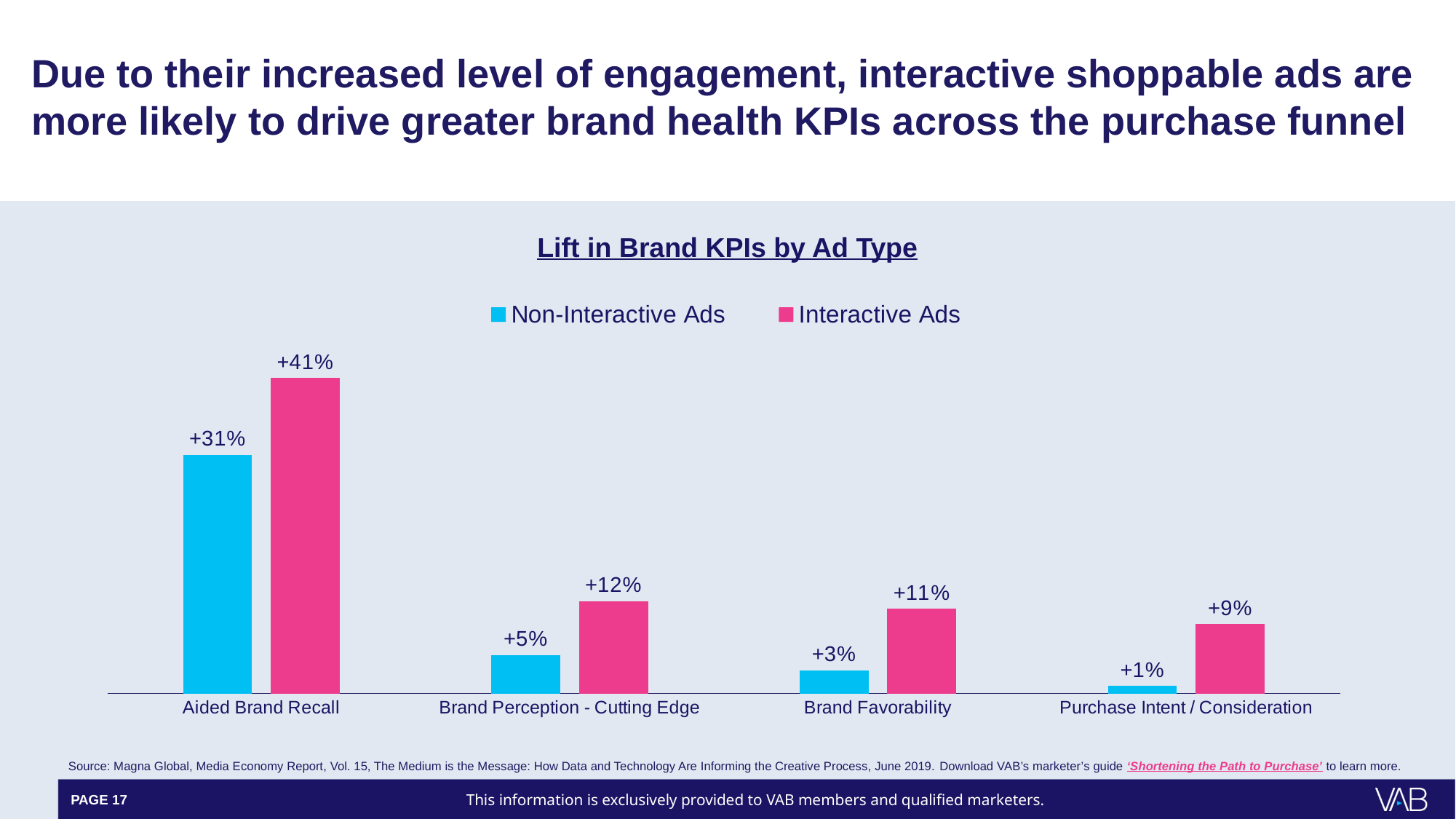
What is the difference between the Interactive Ads and Non-Interactive Ads lift for Brand Favorability? 8 percentage points How many series does the legend list? 2 For Brand Perception - Cutting Edge, which ad type has the larger lift? Interactive Ads What type of chart is shown on the slide? Bar chart How many KPI categories are shown on the x axis? 4 Which KPI shows the highest lift for Interactive Ads? Aided Brand Recall What is the lift in Purchase Intent / Consideration for Interactive Ads? +9% What is the lift in Brand Favorability for Non-Interactive Ads? +3% What is the lift in Aided Brand Recall for Interactive Ads? +41% Which KPI shows the lowest lift for Non-Interactive Ads? Purchase Intent / Consideration What is the difference between the Interactive Ads and Non-Interactive Ads lift for Aided Brand Recall? 10 percentage points What is the lift in Brand Perception - Cutting Edge for Non-Interactive Ads? +5%